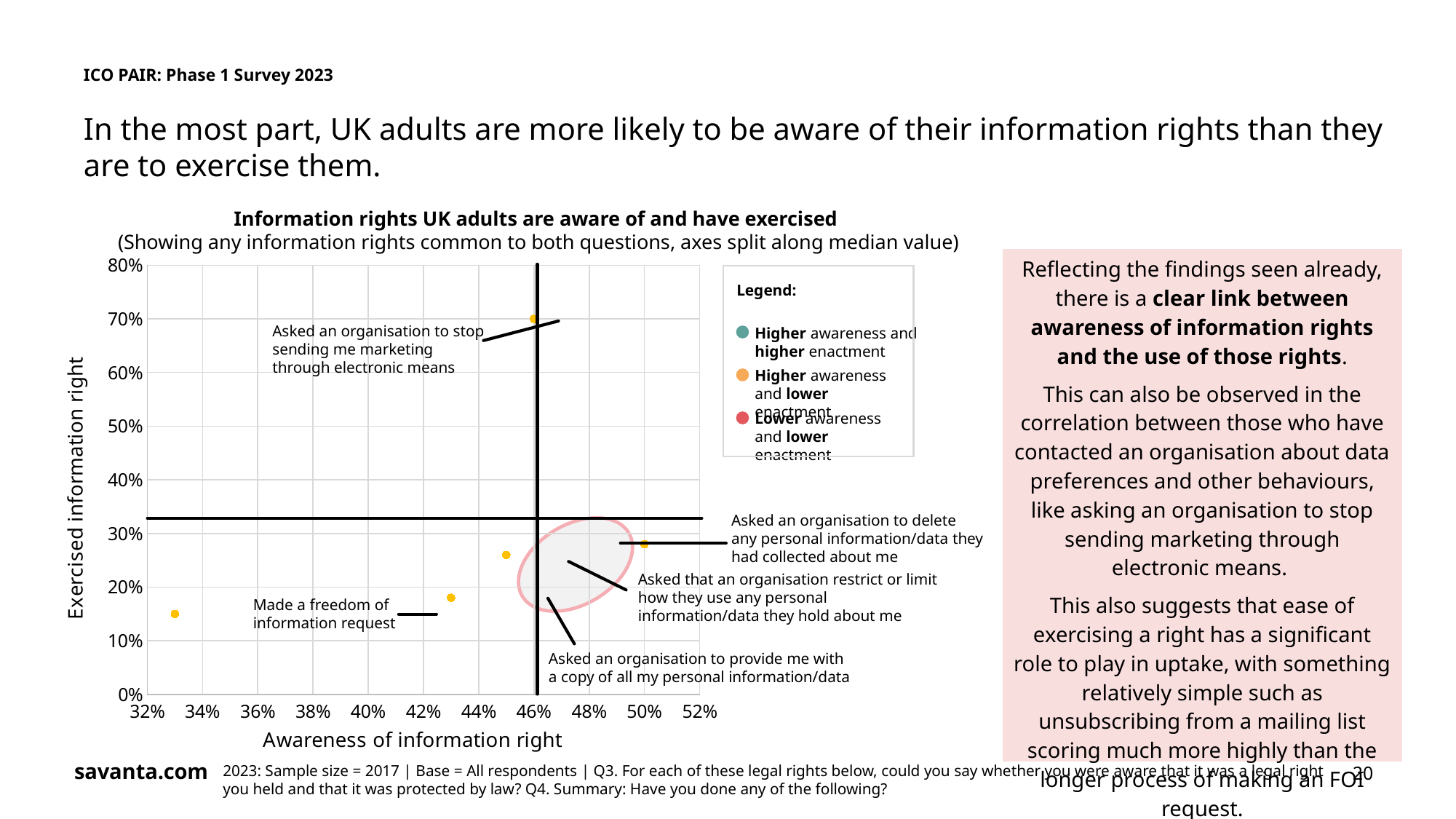
Is the exercised value for 'Asked an organisation to stop sending me marketing through electronic means' greater or less than 60%? greater Is the awareness value for 'Asked an organisation to stop sending me marketing through electronic means' greater or less than 44%? greater Which information right has the highest exercised value on the chart? Asked an organisation to stop sending me marketing through electronic means What kind of chart is shown on the slide? Scatter chart What is the title of the chart's horizontal axis? Awareness of information right Which has a higher exercised value: 'Asked an organisation to stop sending me marketing through electronic means' or 'Made a freedom of information request'? Asked an organisation to stop sending me marketing through electronic means Is the awareness value for 'Asked an organisation to delete any personal information/data they had collected about me' greater or less than 48%? greater How many entries does the chart's legend list? 3